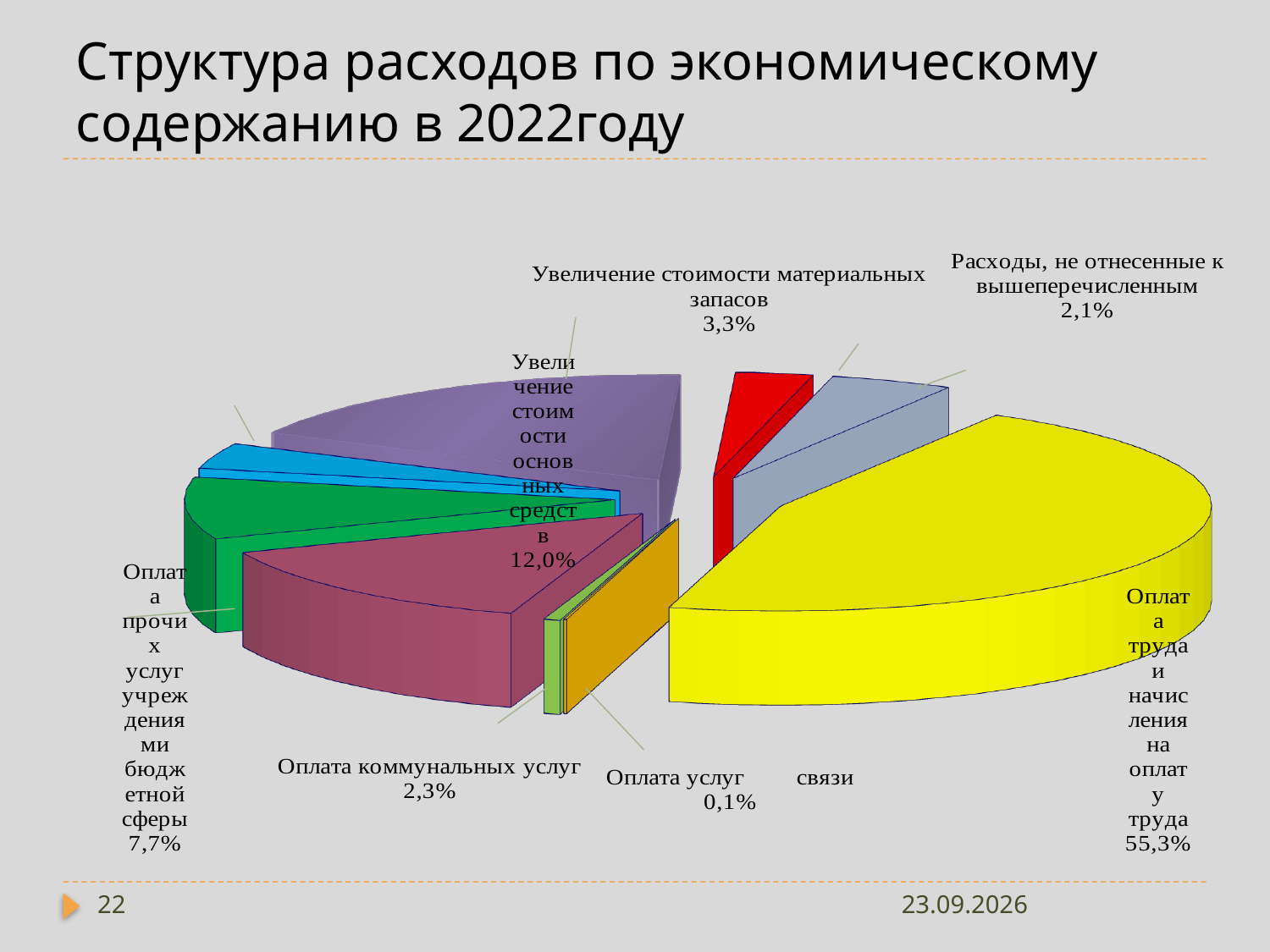
What share of expenses is 'Оплата труда и начисления на оплату труда'? 55,3% Which labelled category has the largest share of expenses? Оплата труда и начисления на оплату труда What share of expenses is 'Расходы, не отнесенные к вышеперечисленным'? 2,1% What share of expenses is 'Оплата прочих услуг учреждениями бюджетной сферы'? 7,7% What share of expenses is 'Увеличение стоимости основных средств'? 12,0% What share of expenses is 'Оплата услуг связи'? 0,1% What share of expenses is 'Увеличение стоимости материальных запасов'? 3,3% What is the difference in percentage points between 'Оплата труда и начисления на оплату труда' and 'Увеличение стоимости основных средств'? 43,3 What kind of chart is shown on the slide? pie chart What share of expenses is 'Оплата коммунальных услуг'? 2,3% Which is larger: the share for 'Оплата коммунальных услуг' or for 'Увеличение стоимости материальных запасов'? Увеличение стоимости материальных запасов Which labelled category has the smallest share of expenses? Оплата услуг связи